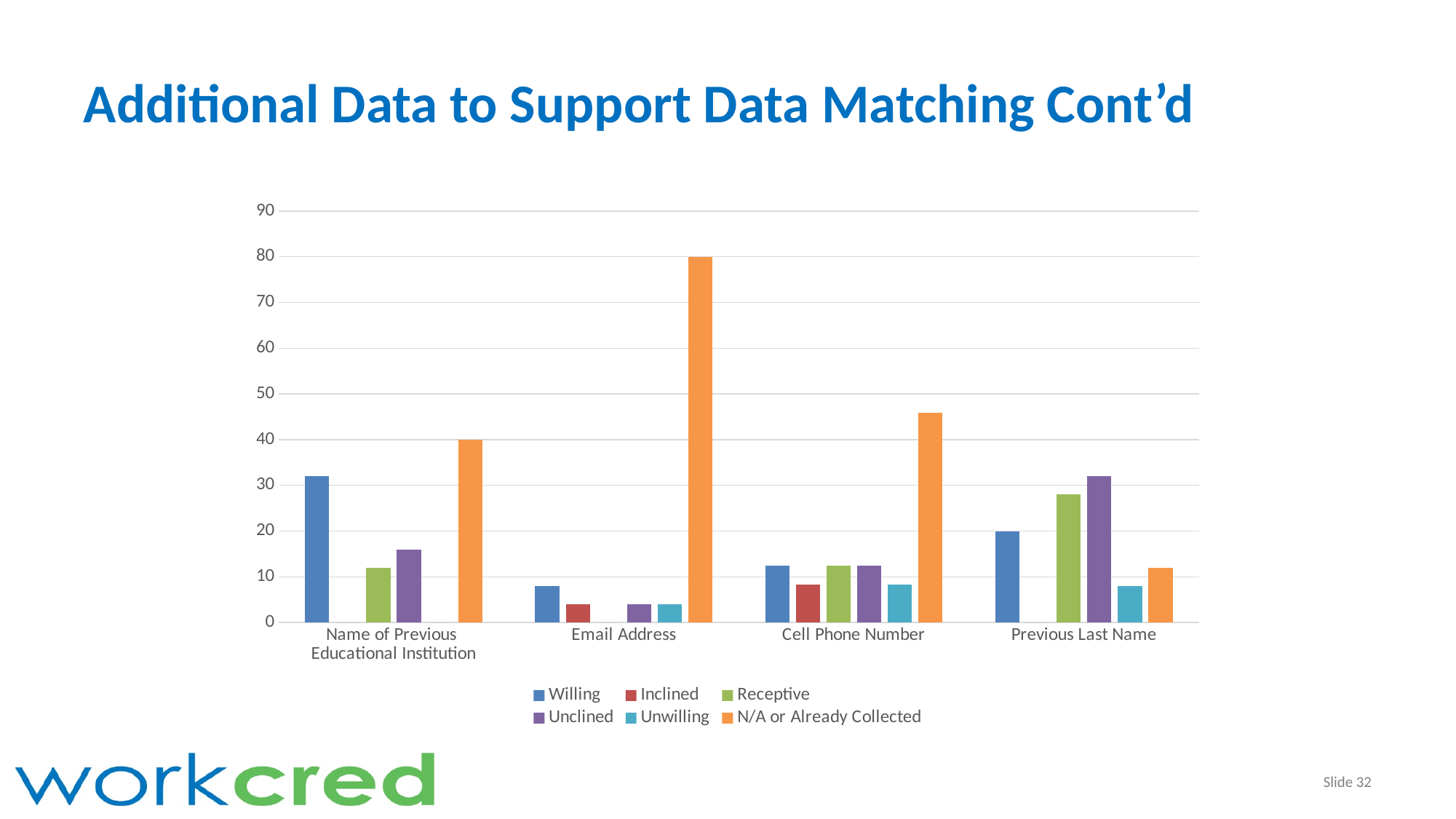
What colour represents N/A or Already Collected in the legend? orange How many categories are shown on the x axis? 4 For Previous Last Name, which is larger: Unclined or Willing? Unclined Which category has the lowest N/A or Already Collected bar? Previous Last Name Which category has the highest N/A or Already Collected bar? Email Address What kind of chart is shown on the slide? bar chart Is the N/A or Already Collected value for Cell Phone Number greater or less than 40? greater For Name of Previous Educational Institution, which is larger: Willing or Receptive? Willing What is the N/A or Already Collected value for Email Address? 80 How many series does the legend list? 6 Is the Willing value for Name of Previous Educational Institution greater or less than 30? greater Is the Inclined value for Email Address greater or less than 10? less